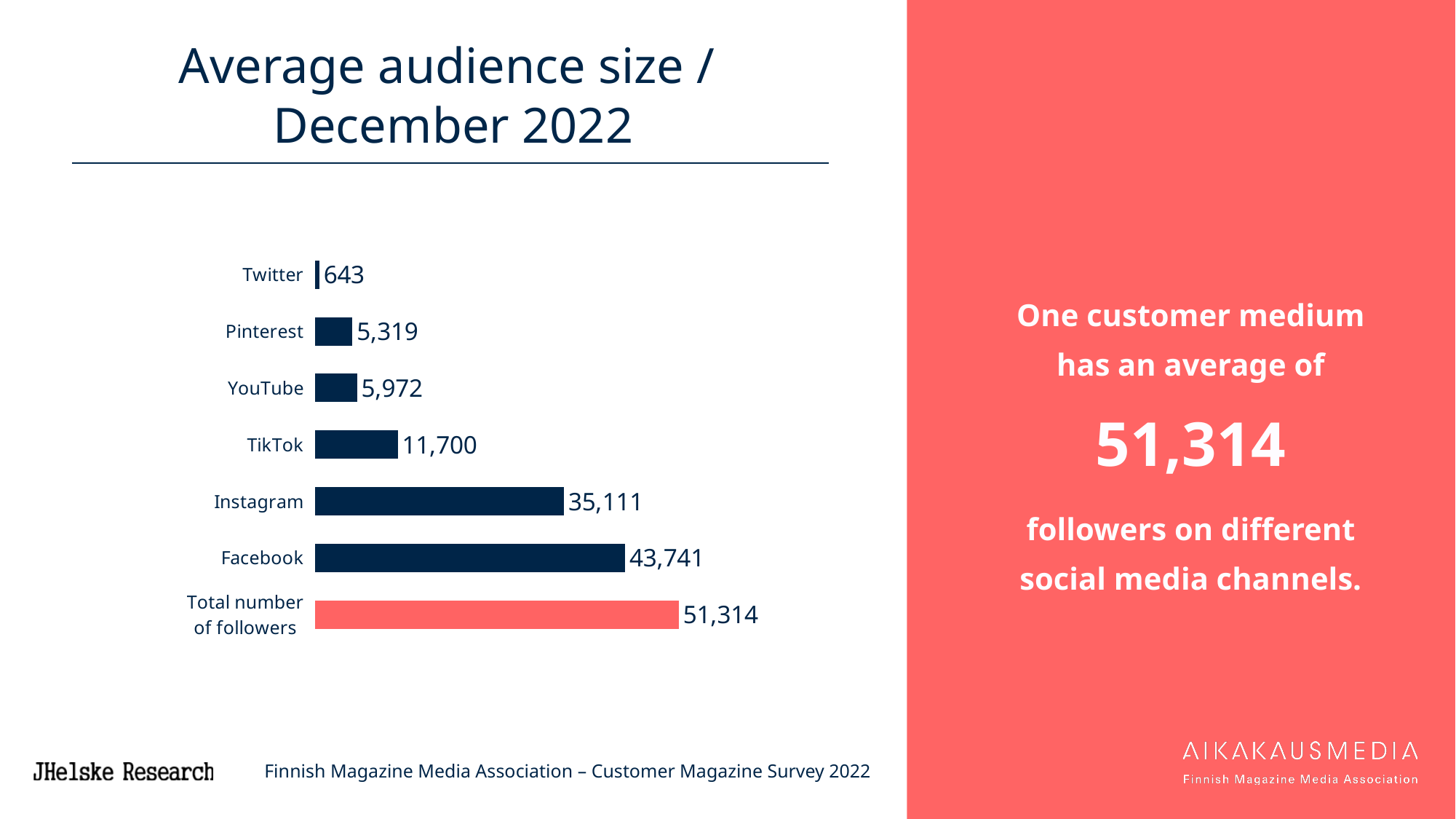
What type of chart is shown on the slide? Bar chart What is the value shown for Total number of followers? 51,314 Which channel has the smallest average audience size? Twitter Which individual social media channel has the largest average audience size? Facebook What is the average audience size for TikTok? 11,700 Which has a larger average audience size, YouTube or Pinterest? YouTube What is the average audience size for Facebook? 43,741 What is the difference between the Facebook and Instagram average audience sizes? 8,630 How many bars are shown in the chart? 7 Which bar in the chart is coloured differently (red) from the others? Total number of followers What is the difference between the YouTube and Pinterest average audience sizes? 653 What is the average audience size for Twitter? 643